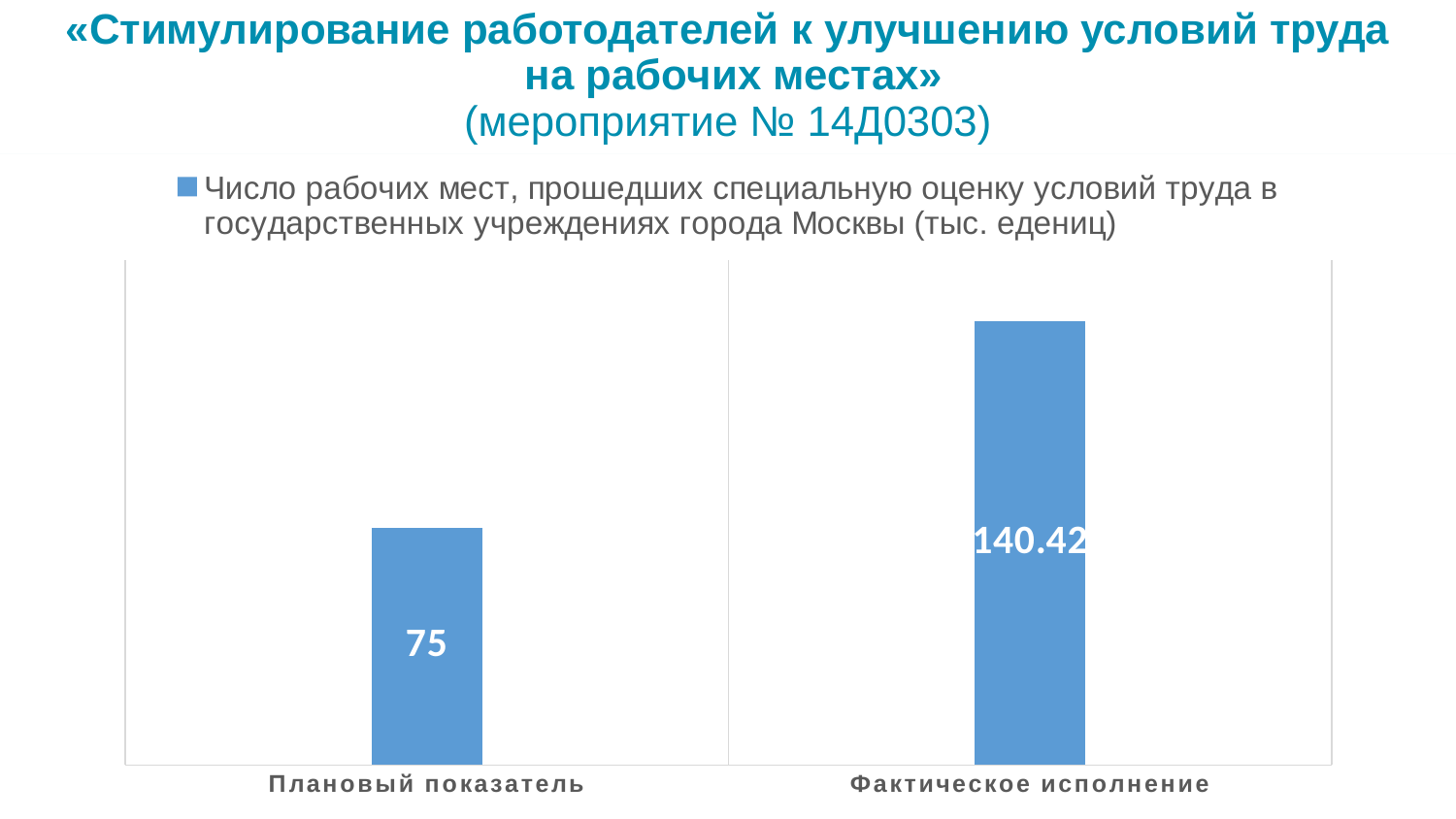
Do the values rise or fall from Плановый показатель to Фактическое исполнение? rise What is the event number given in the slide title? 14Д0303 What is the difference between the values for Фактическое исполнение and Плановый показатель? 65.42 What is the value for Плановый показатель? 75 How many categories are shown on the x axis? 2 What is the value for Фактическое исполнение? 140.42 Which category has the highest value? Фактическое исполнение Which category has the lowest value? Плановый показатель Which is larger, the value for Плановый показатель or the value for Фактическое исполнение? Фактическое исполнение What unit is given in the legend entry? тыс. едениц How many series does the legend list? 1 What kind of chart is shown on the slide? bar chart